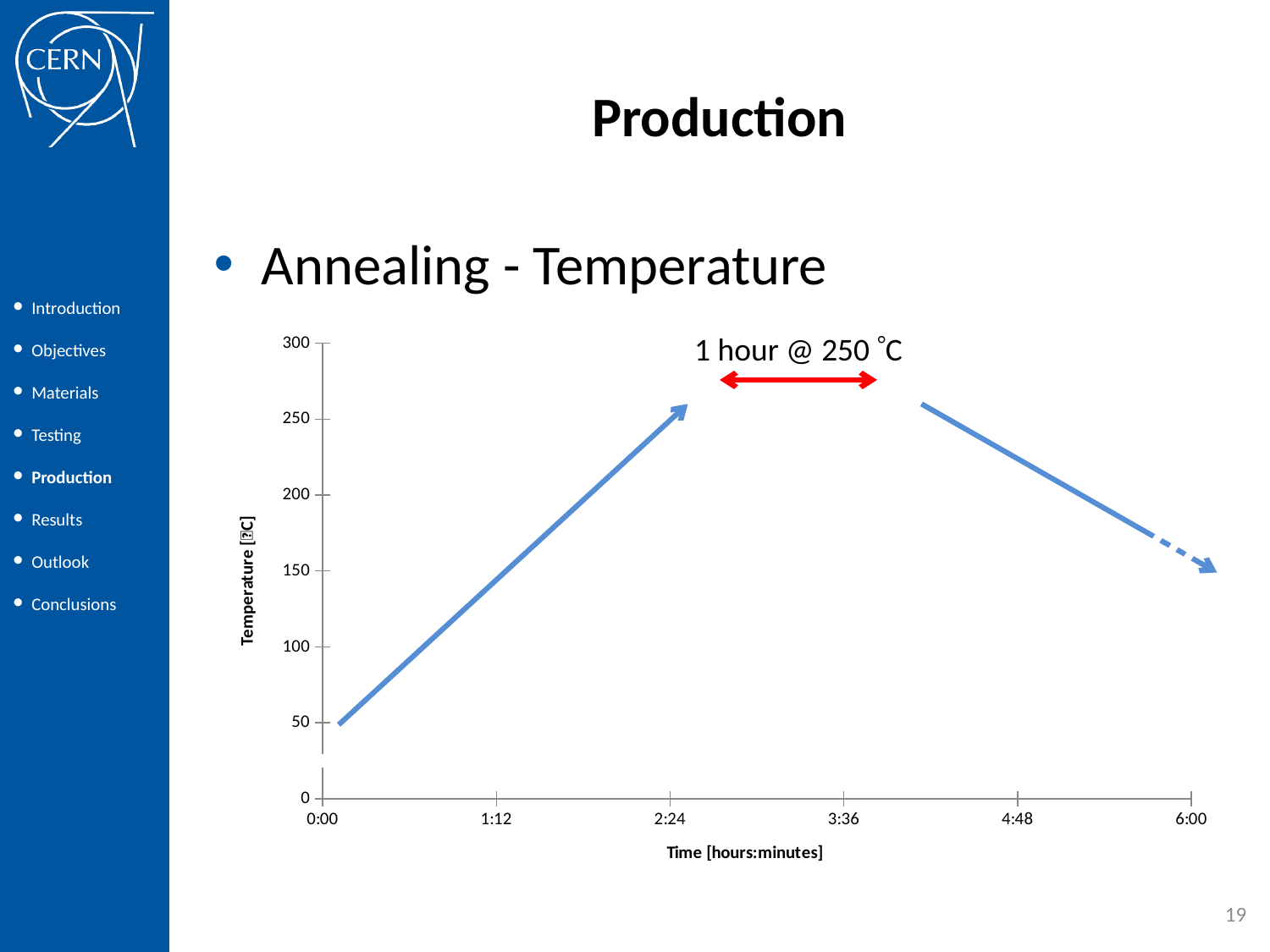
Does the temperature rise or fall along the x axis after about 3:36? fall What is the highest value shown on the y axis of the chart? 300 Does the temperature rise or fall along the x axis between 0:00 and 2:24? rise What is the last time label shown on the x axis of the chart? 6:00 Is the peak temperature reached on the chart greater or less than 200? greater How many time labels are shown on the x axis of the chart? 6 What is the title of the y axis on the chart? Temperature [°C] Is the starting temperature at 0:00 greater or less than 100? less According to the annotation on the chart, at what temperature is the sample held? 250 °C What is the title of the x axis on the chart? Time [hours:minutes] According to the annotation on the chart, for how long is the temperature held at 250 °C? 1 hour